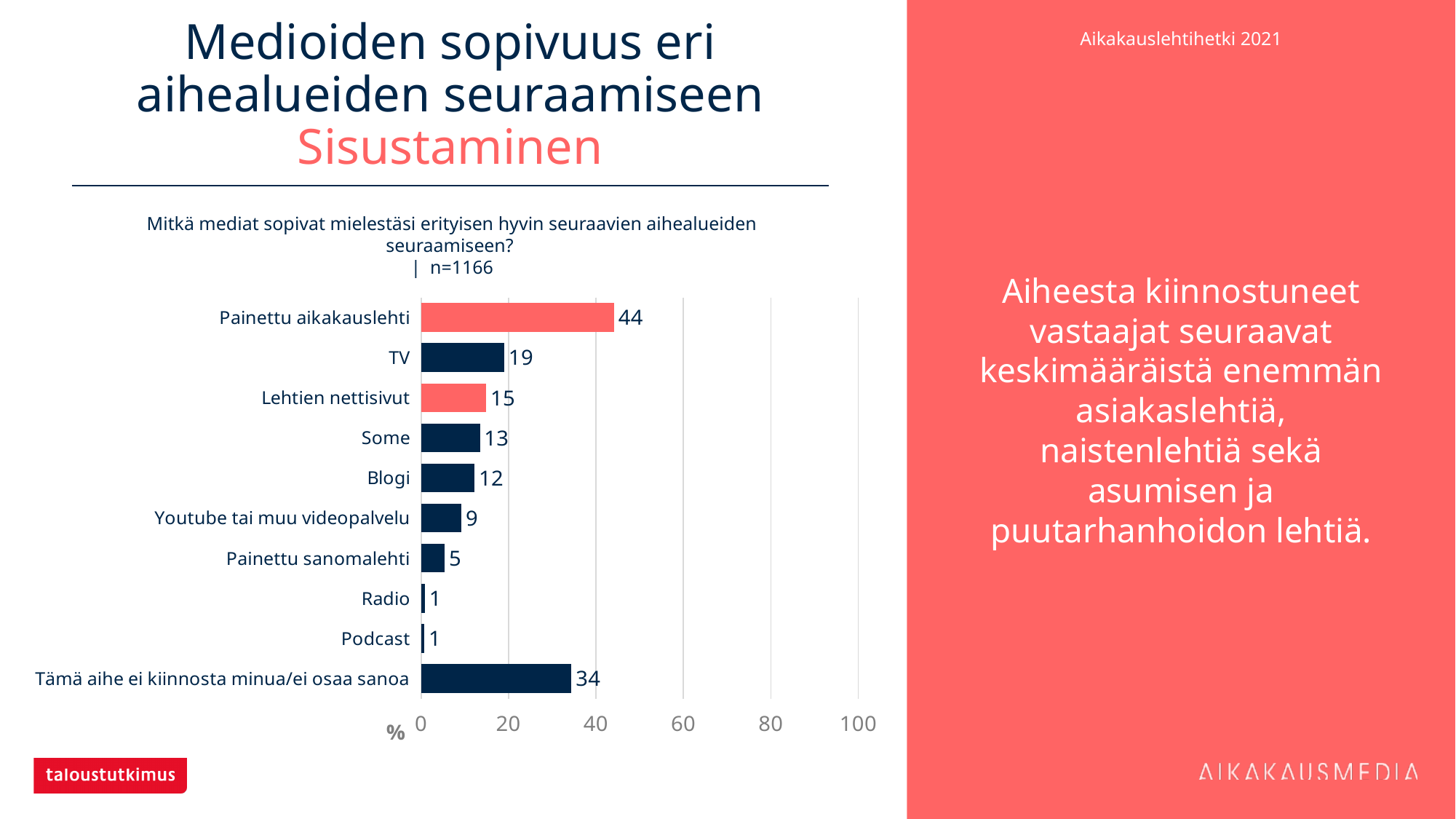
What is the value for Tämä aihe ei kiinnosta minua/ei osaa sanoa? 34 What kind of chart is shown on the slide? bar chart What is the difference between the values for Painettu aikakauslehti and TV? 25 What is the value for Painettu aikakauslehti? 44 Which category has the highest value? Painettu aikakauslehti What is the value for TV? 19 What is the sample size (n) stated above the chart? n=1166 How many categories are shown in the chart? 10 What is the value for Painettu sanomalehti? 5 Which is larger, the value for Some or the value for Blogi? Some What is the value for Lehtien nettisivut? 15 Is the value for Painettu aikakauslehti greater or less than 40? greater